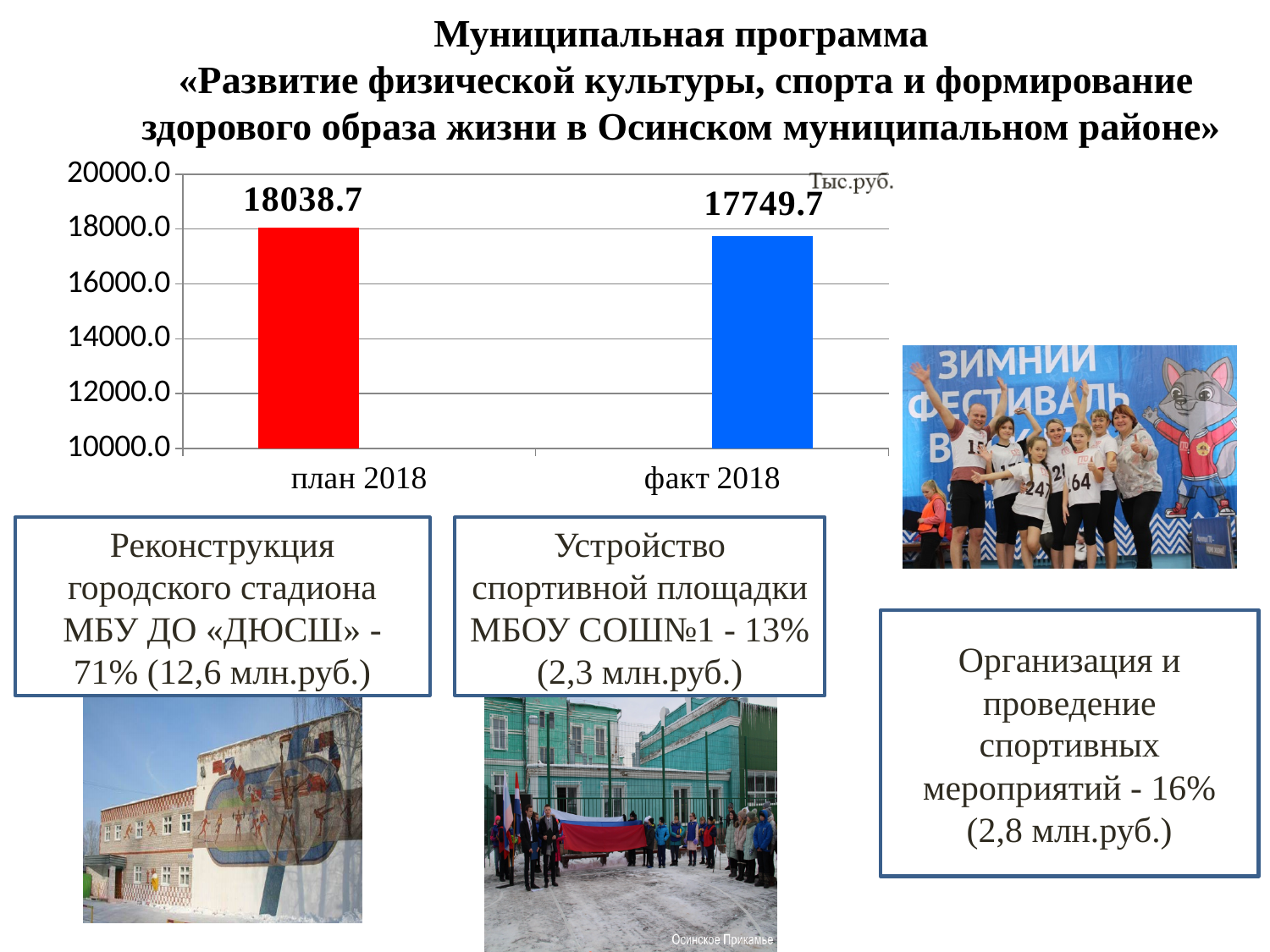
Which category has the highest value on the chart? план 2018 What unit is indicated on the chart? Тыс.руб. Do the values rise or fall from план 2018 to факт 2018? fall Which category has the higher value, план 2018 or факт 2018? план 2018 How many categories are shown on the chart? 2 What is the value for факт 2018? 17749.7 Which category has the lowest value on the chart? факт 2018 What is the value for план 2018? 18038.7 What is the difference between the values for план 2018 and факт 2018? 289.0 Is the value for факт 2018 greater or less than 18000.0? less Is the value for план 2018 greater or less than 18000.0? greater What kind of chart is shown on the slide? bar chart